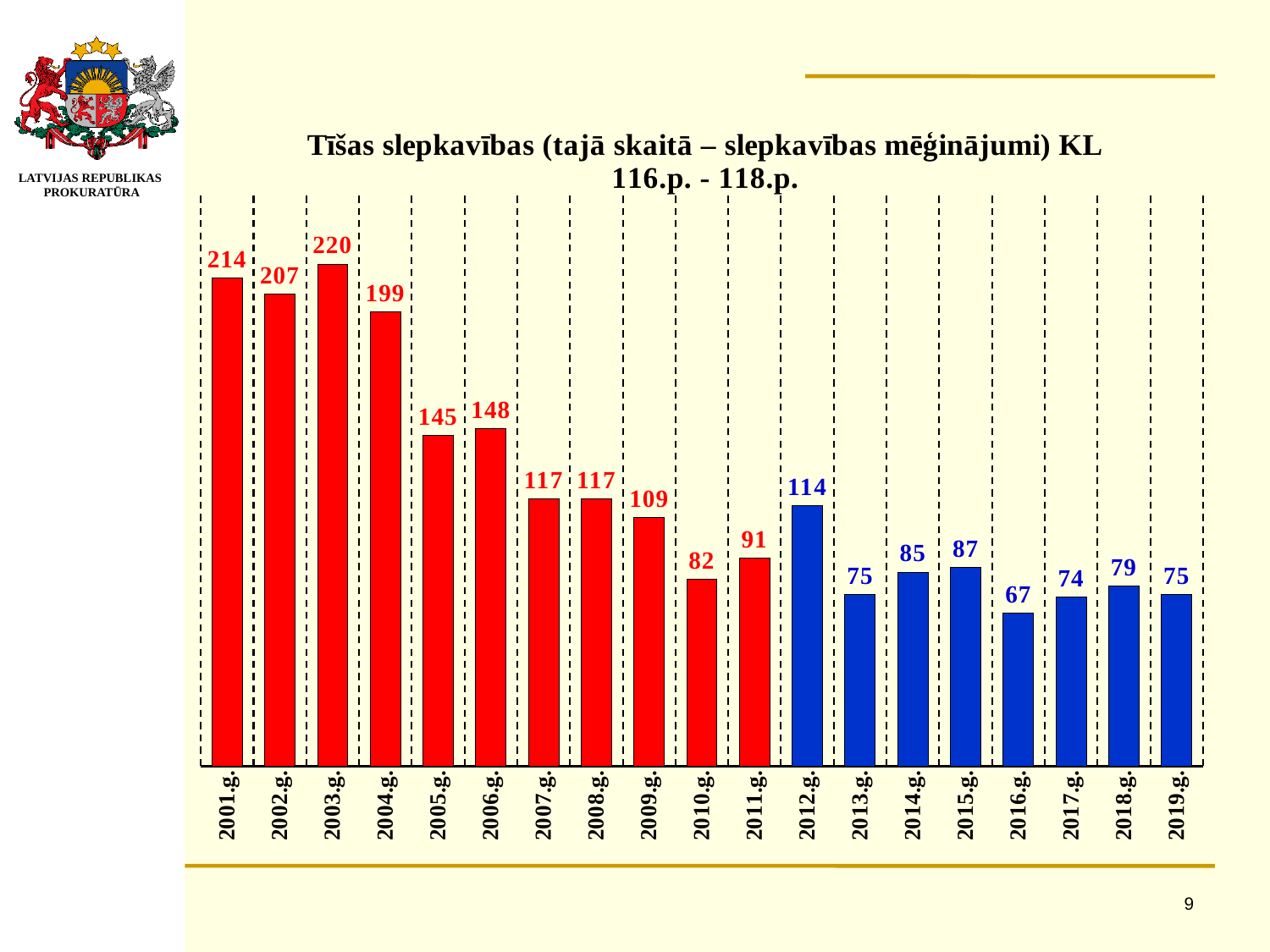
What is the value for 2003.g.? 220 What is the value for 2012.g.? 114 What kind of chart is shown on the slide? bar chart What is the value for 2016.g.? 67 What is the difference between the values for 2012.g. and 2013.g.? 39 What is the difference between the values for 2001.g. and 2002.g.? 7 Which year has the highest value? 2003.g. Do the values generally rise or fall from 2001.g. to 2019.g.? fall Which year has the lowest value? 2016.g. What colour are the bars from 2012.g. onwards? blue Which is larger, the value for 2005.g. or the value for 2006.g.? 2006.g. How many years are shown on the x axis? 19